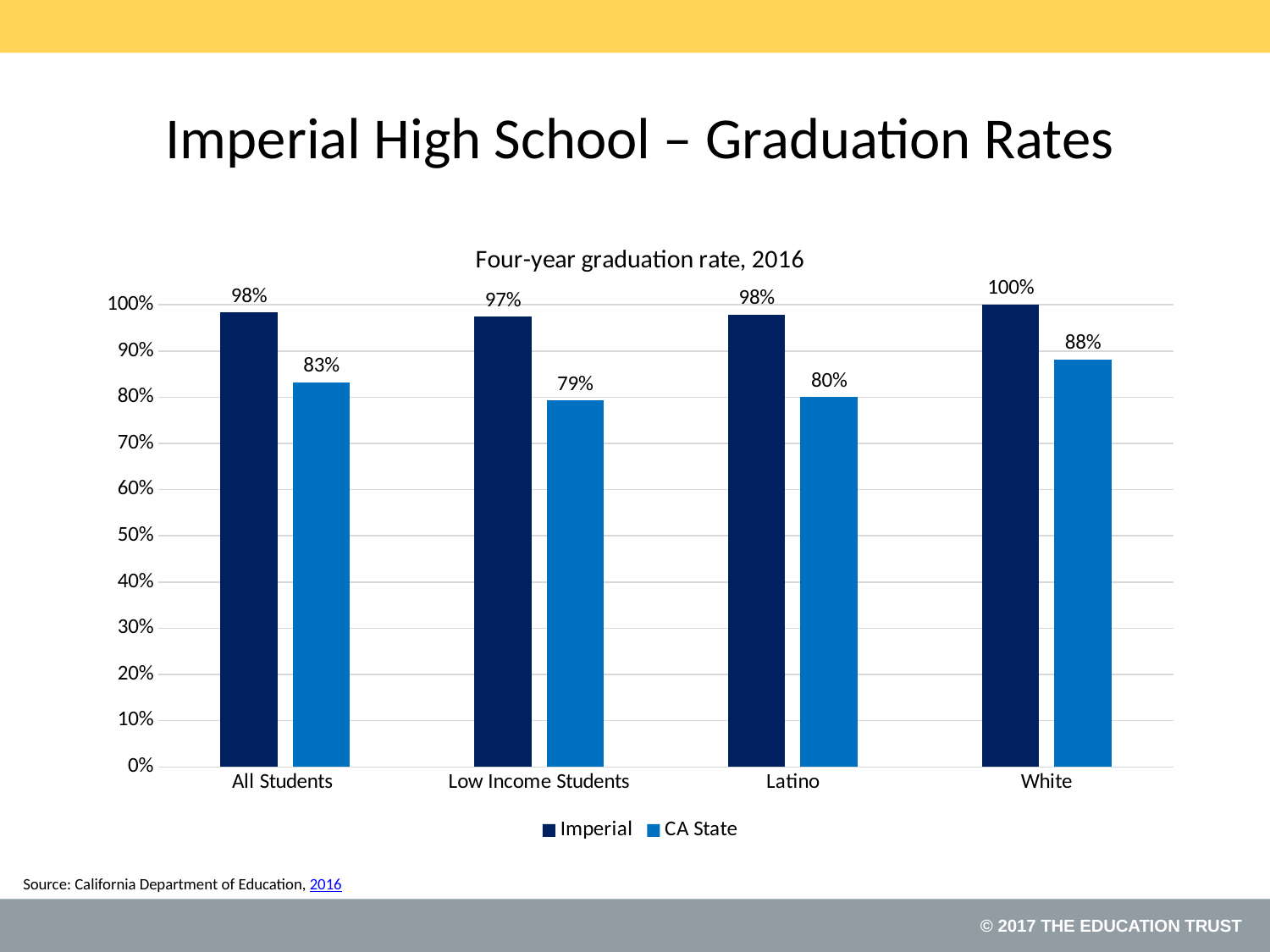
What is the Imperial four-year graduation rate for All Students? 98% What is the CA State four-year graduation rate for Low Income Students? 79% What kind of chart is shown on the slide? Bar chart How many series does the legend list? 2 Which is larger, the Imperial rate for Low Income Students or the CA State rate for White students? Imperial rate for Low Income Students How many student categories are shown on the x axis? 4 What is the difference between the Imperial and CA State graduation rates for Latino students? 18% Which category has the highest Imperial graduation rate? White What is the CA State graduation rate for White students? 88% Which category has the lowest CA State graduation rate? Low Income Students What is the difference between the Imperial and CA State graduation rates for Low Income Students? 18% What is the title of the chart? Four-year graduation rate, 2016